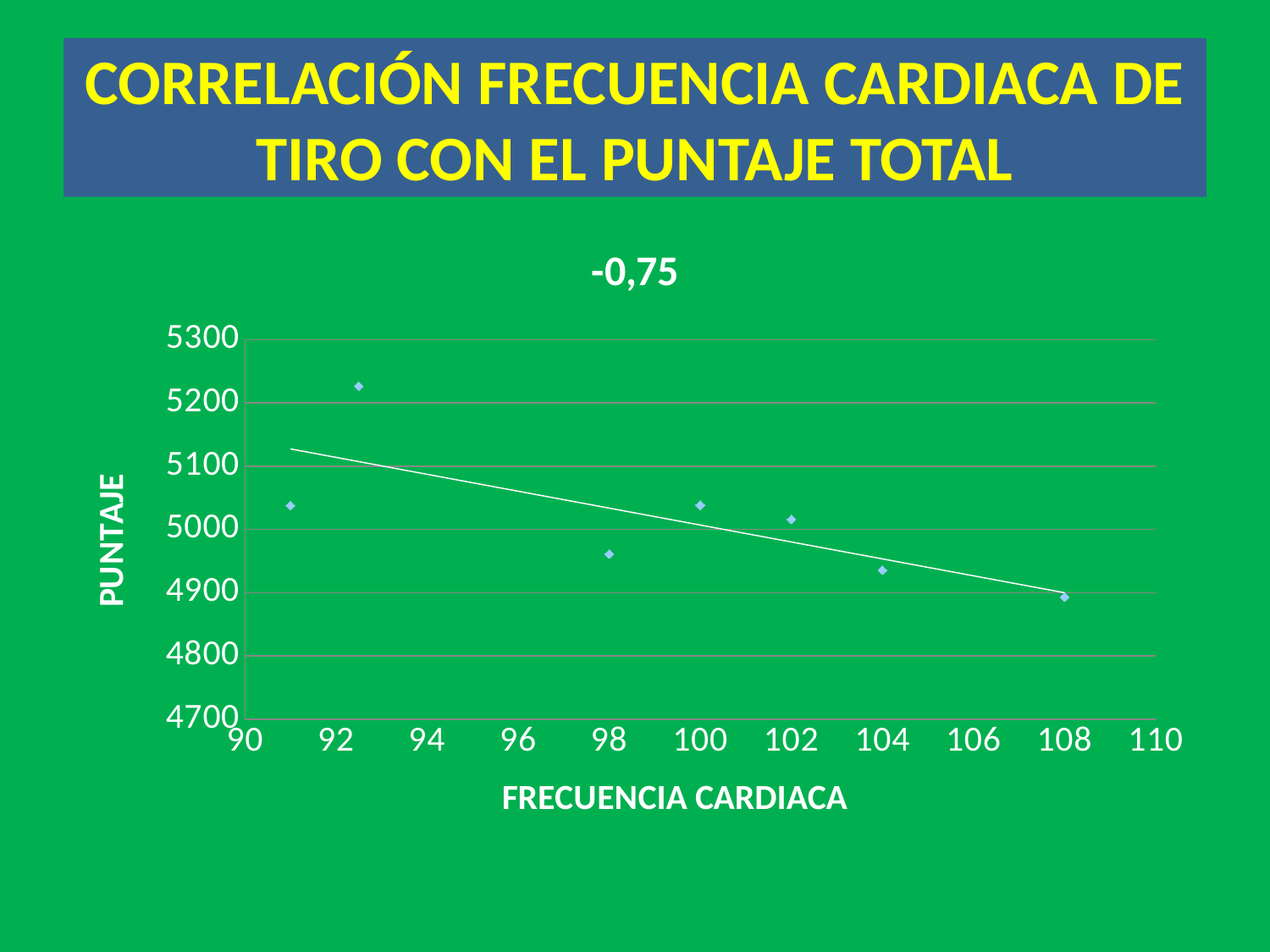
What kind of chart is shown on the slide? scatter chart Which point has the highest PUNTAJE: the one near a heart rate of 92-93 or the one at 108? the one near 92-93 Which point has the lowest PUNTAJE value on the chart, by heart rate? the point at 108 Is the PUNTAJE value of the point at a heart rate of 100 greater or less than 5000? greater What is the title shown above the chart? -0,75 Is the PUNTAJE value of the point at a heart rate of 98 greater or less than 5000? less How many data points are plotted on the chart? 7 Do the PUNTAJE values generally rise or fall as FRECUENCIA CARDIACA increases along the x axis? fall Is the PUNTAJE value of the point at a heart rate of 104 greater or less than 5000? less What is the label of the x axis? FRECUENCIA CARDIACA